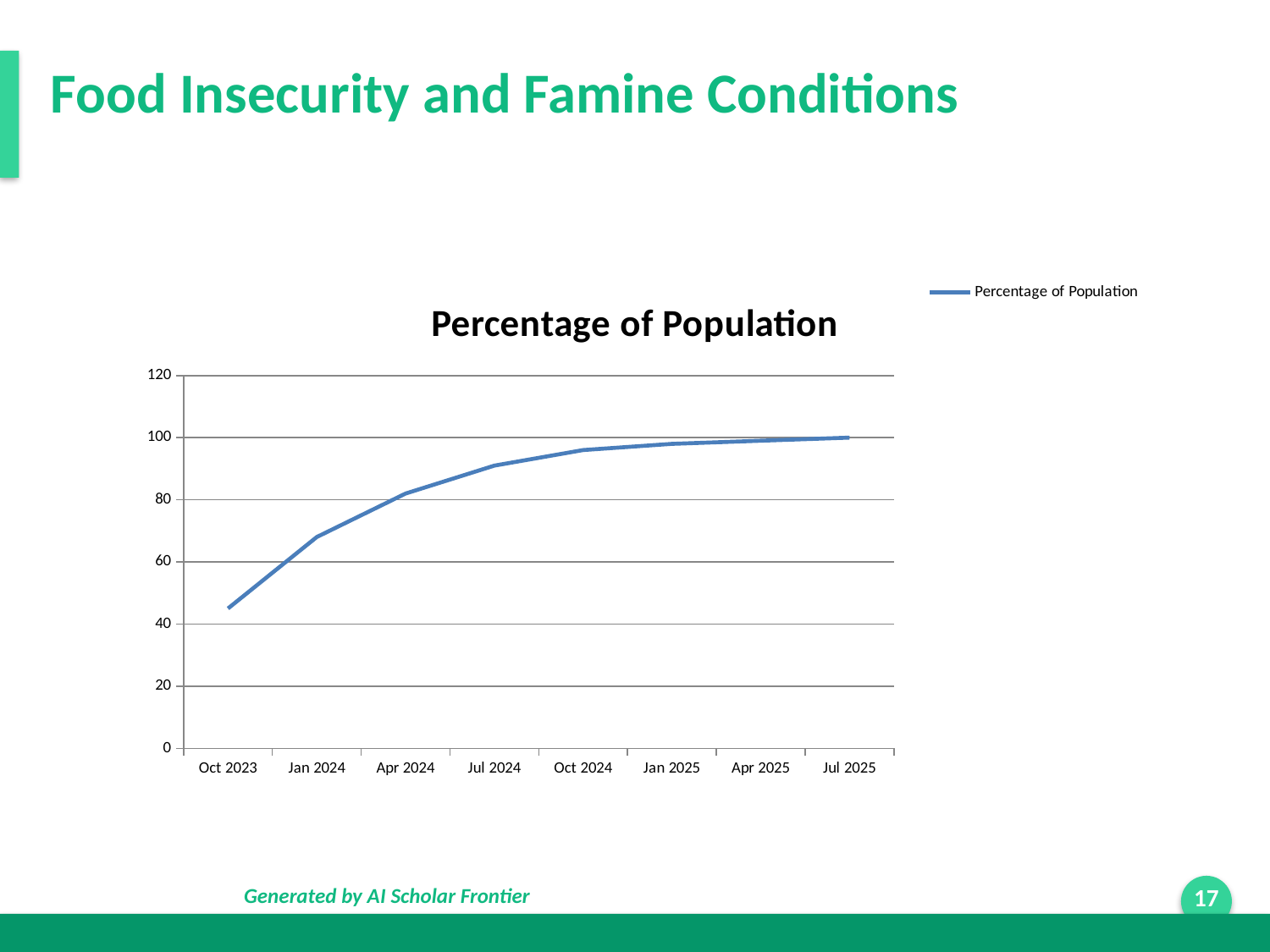
Is the value for Jan 2024 greater or less than 60? greater Which is larger, the value for Oct 2023 or the value for Apr 2024? Apr 2024 How many points are plotted along the x axis? 8 Is the value for Apr 2024 greater or less than 100? less Do the values rise or fall from Oct 2023 to Jul 2025? rise Is the value for Jul 2024 greater or less than 80? greater What kind of chart is shown on the slide? line chart Which date has the lowest value? Oct 2023 How many series does the legend list? 1 What is the title of the chart? Percentage of Population What is the first date shown on the x axis? Oct 2023